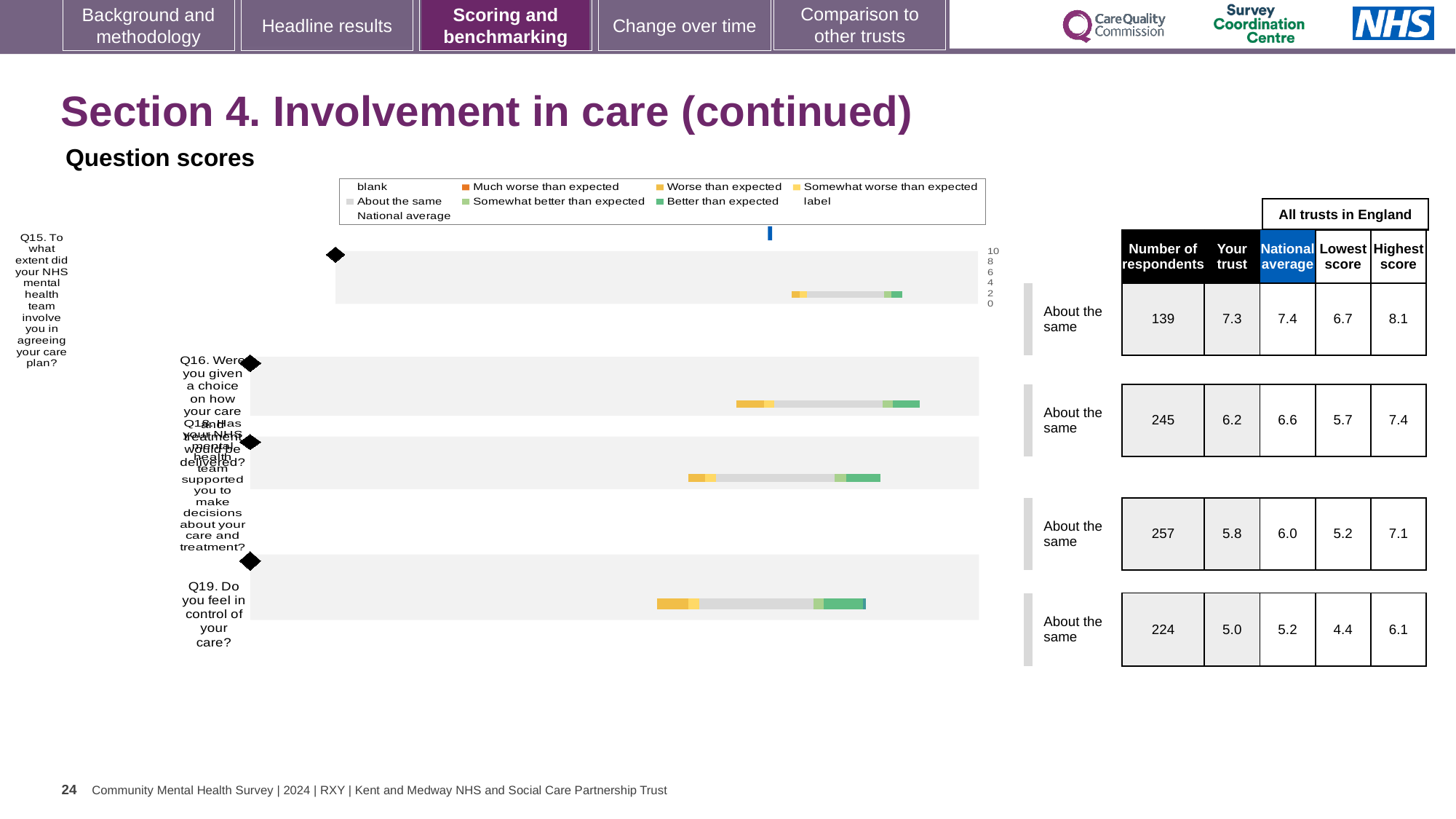
Which question has the lowest 'Your trust' score in the table beside the chart? Q19 What benchmark label is shown next to the bar for Q15? About the same What kind of chart is used to show the question scores on this slide? Bar chart What is the heading given to the chart on this slide? Question scores According to the table beside the chart, what is the 'Your trust' score for Q15 (involving you in agreeing your care plan)? 7.3 How many respondents answered Q16 according to the table beside the chart? 245 Which question has the highest 'Your trust' score in the table beside the chart? Q15 For Q16, what is the difference between the national average score and the 'Your trust' score? 0.4 How many questions (categories) are plotted in the Question scores chart? 4 For Q18, which is larger: the 'Your trust' score or the national average score? National average What is the highest score among all trusts in England for Q18? 7.1 According to the table beside the chart, what is the national average score for Q19 (feeling in control of your care)? 5.2